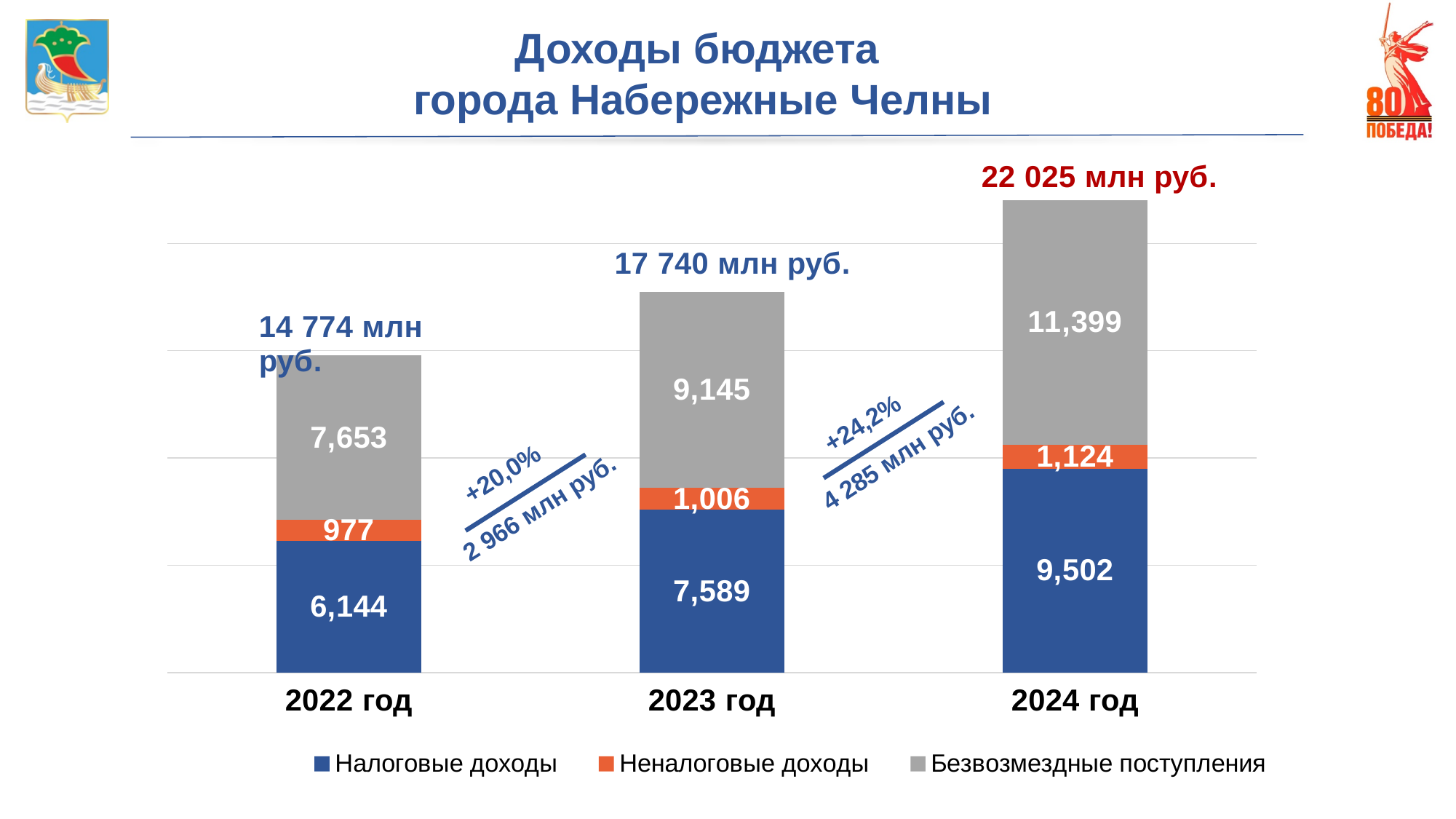
What total is printed above the bar for 2023 год? 17 740 млн руб. How many years are shown on the x axis? 3 What is the difference between Налоговые доходы in 2024 год and 2023 год? 1,913 Which is larger: Безвозмездные поступления in 2023 год or Налоговые доходы in 2024 год? Налоговые доходы in 2024 год Which year has the highest value for Налоговые доходы? 2024 год What total is printed above the bar for 2024 год? 22 025 млн руб. What is the value of Безвозмездные поступления for 2024 год? 11,399 How many series does the legend list? 3 What is the value of Неналоговые доходы for 2023 год? 1,006 What kind of chart is shown on the slide? Stacked bar chart Which year has the lowest value for Безвозмездные поступления? 2022 год What is the value of Налоговые доходы for 2022 год? 6,144